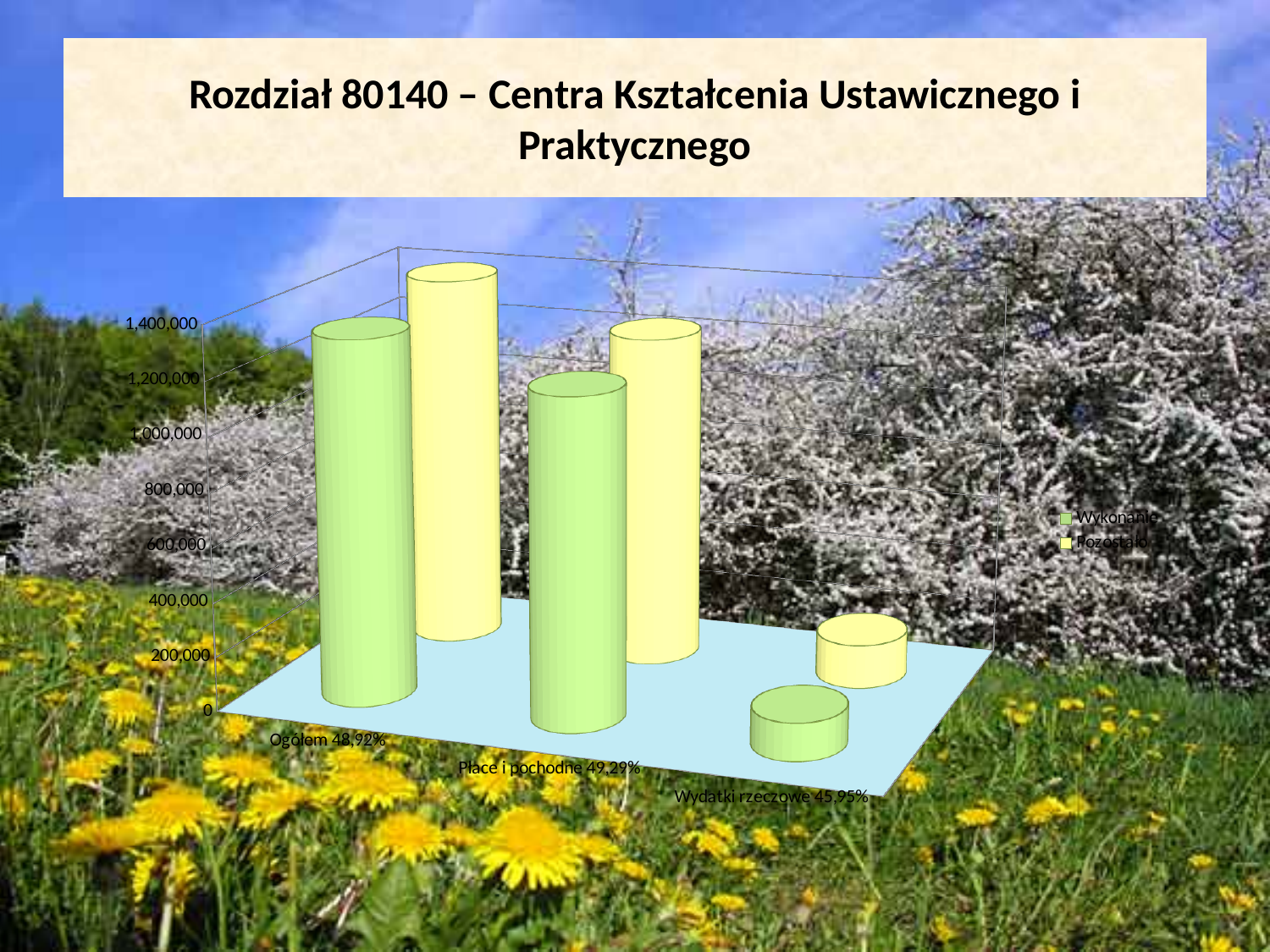
Is the Wykonanie value for Ogółem 48,92% greater or less than 1,000,000? greater Is the Wykonanie value for Wydatki rzeczowe 45,95% greater or less than 400,000? less Which category has the highest Wykonanie value? Ogółem 48,92% What are the two series named in the chart legend? Wykonanie and Pozostało How many categories are shown on the x axis of the chart? 3 Which is larger: the Wykonanie value for Ogółem 48,92% or the Wykonanie value for Wydatki rzeczowe 45,95%? Ogółem 48,92% Which category has the lowest Wykonanie value? Wydatki rzeczowe 45,95% How many series does the chart legend list? 2 Which is larger: the Pozostało value for Płace i pochodne 49,29% or the Pozostało value for Wydatki rzeczowe 45,95%? Płace i pochodne 49,29% Which category has the lowest Pozostało value? Wydatki rzeczowe 45,95% What is the title of the slide containing the chart? Rozdział 80140 – Centra Kształcenia Ustawicznego i Praktycznego What kind of chart is shown on the slide? bar chart